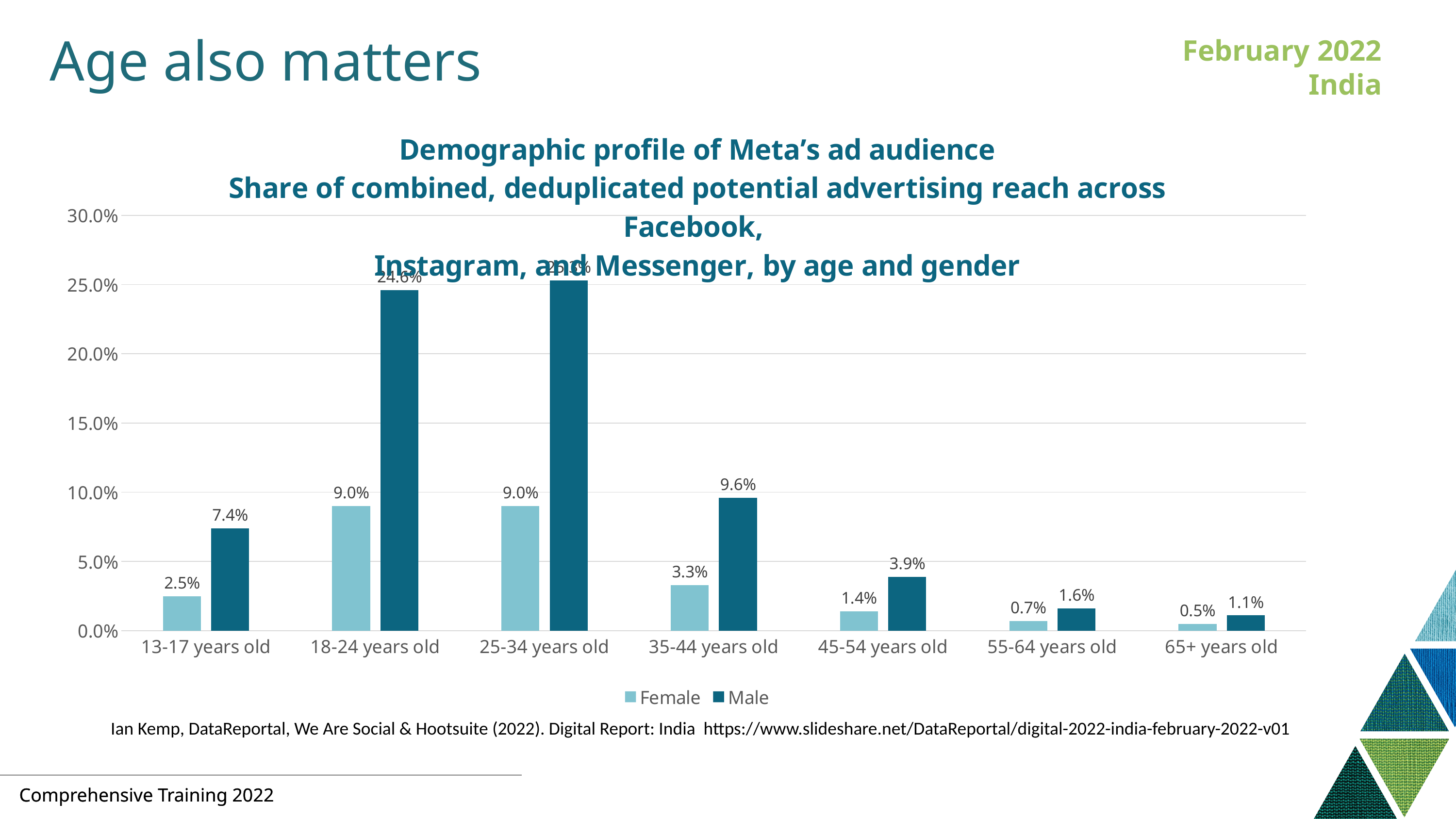
What kind of chart is shown on the slide? bar chart What is the Female value for 45-54 years old? 1.4% What is the Male value for 35-44 years old? 9.6% What is the Male value for 18-24 years old? 24.6% Which age group has the lowest Female value? 65+ years old How many series does the legend list? 2 What is the Female value for 13-17 years old? 2.5% Which age group has the lowest Male value? 65+ years old Which is larger for 55-64 years old, the Female value or the Male value? Male How many age groups are shown on the x axis? 7 What is the difference between the Male and Female values for 35-44 years old? 6.3% Is the Male value for 18-24 years old greater or less than 20.0%? greater